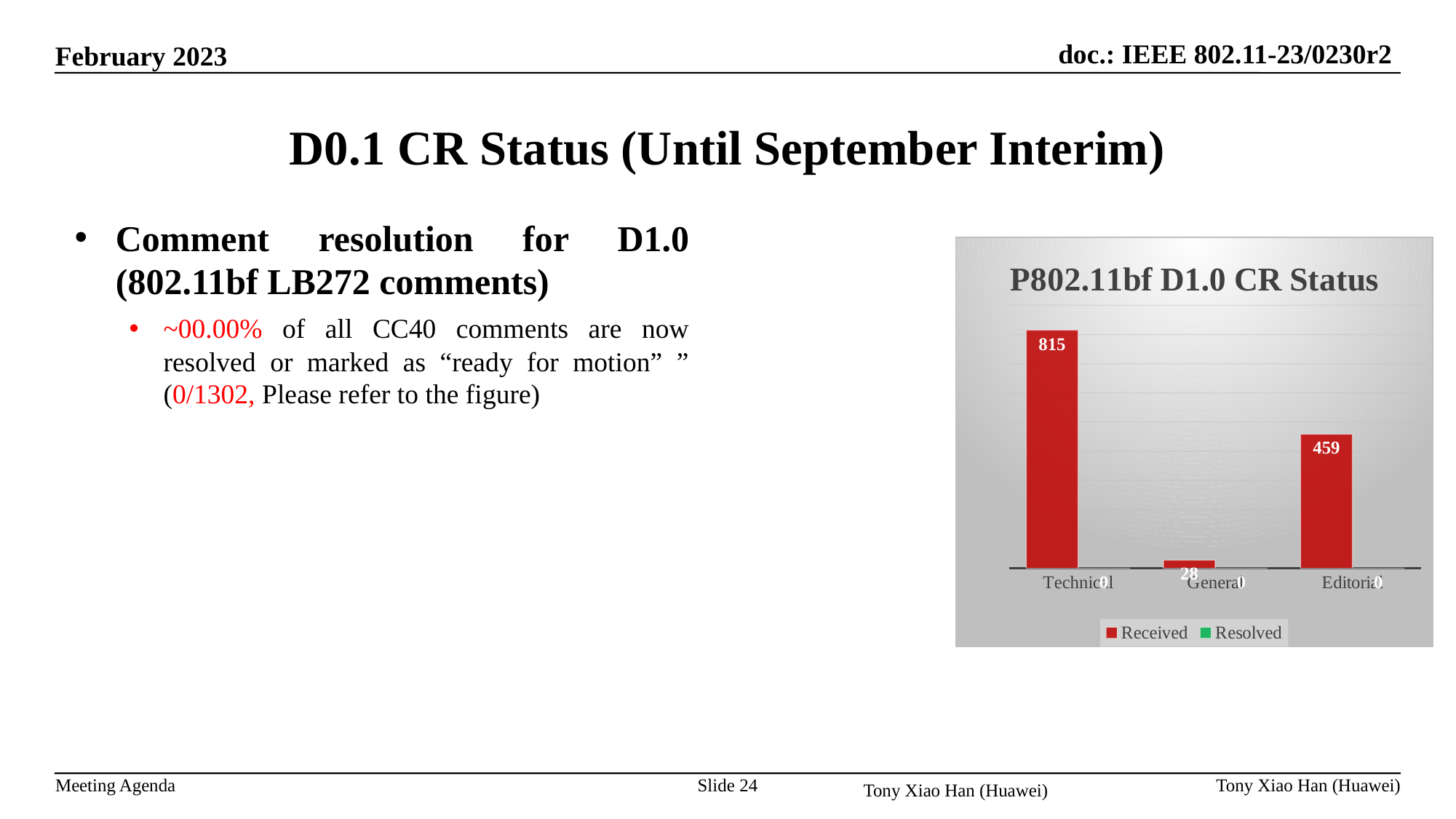
What is the Received value for Technical? 815 What is the Received value for Editorial? 459 What is the title of the chart? P802.11bf D1.0 CR Status Which category has the highest Received value? Technical How many series does the chart legend list? 2 What is the difference between the Received values for Technical and Editorial? 356 Which is larger, the Received value for Editorial or for General? Editorial Which series are listed in the chart legend? Received and Resolved What is the Received value for General? 28 How many categories are shown on the x axis of the chart? 3 Which category has the lowest Received value? General What kind of chart is shown on the slide? bar chart